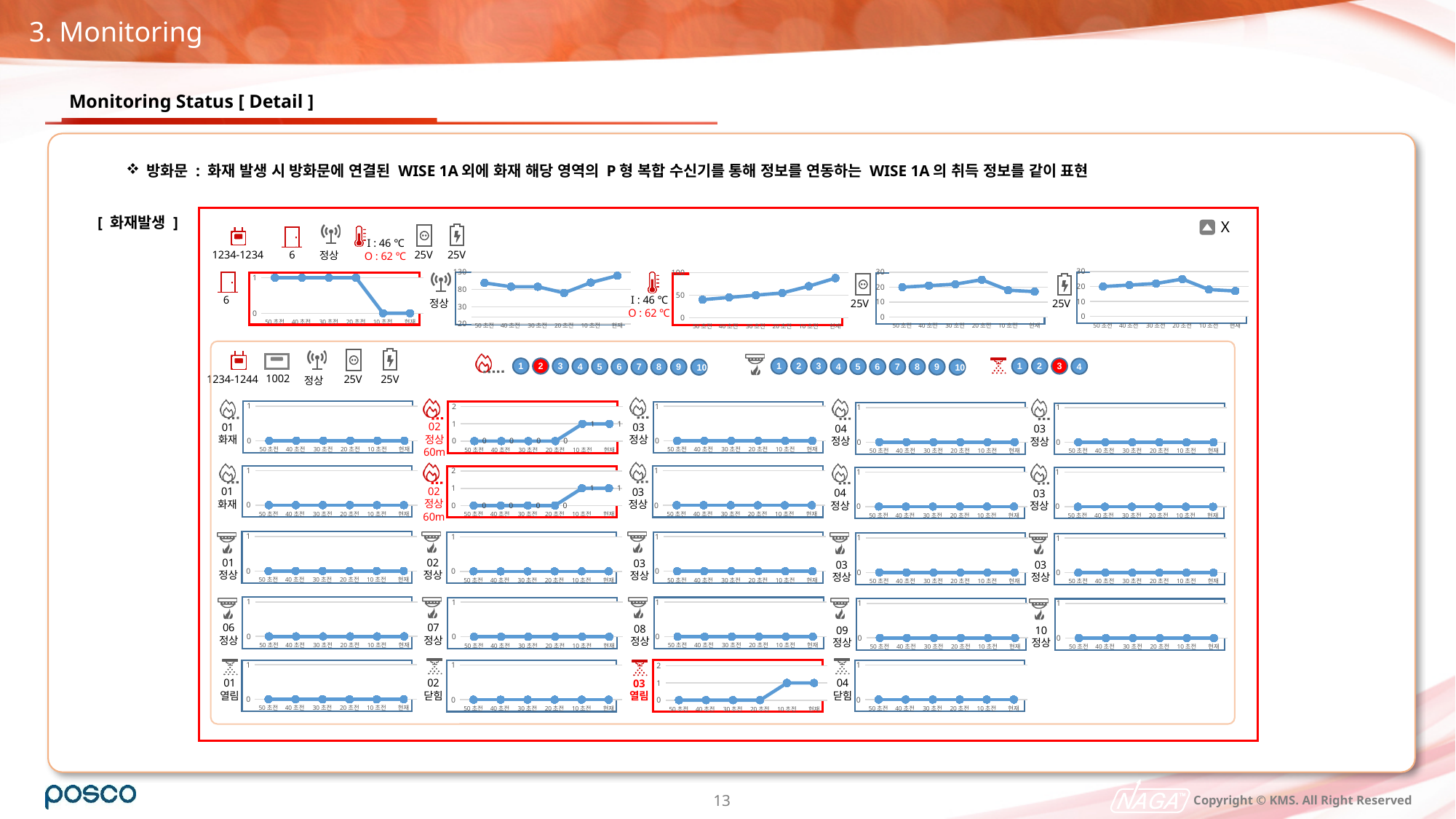
What kind of charts are shown in the monitoring panel on the slide? line charts In the top-row signal chart (정상), is the value at 현재 greater or less than 80? greater What is the label of the last x-axis tick on each small chart? 현재 In the red-bordered chart for 02 정상 60m in the first row of the lower grid, what is the value at 50초전? 0 In the top-row door chart (labelled 6), does the value rise or fall from 50초전 to 현재? fall How many time points are plotted along the x axis of each small chart (from 50초전 to 현재)? 6 In the top-row door chart (labelled 6), what is the value at 50초전? 1 In the red-bordered chart for 03 열림 in the bottom row of the lower grid, does the value rise or fall from 50초전 to 현재? rise In the red-bordered chart for 02 정상 60m in the first row of the lower grid, what is the value at 현재? 1 In the top-row temperature chart (I : 46 °C / O : 62 °C), is the value at 현재 greater or less than 50? greater In the top-row door chart (labelled 6), what is the value at 현재? 0 In the top-row temperature chart (I : 46 °C / O : 62 °C), does the value rise or fall from 50초전 to 현재? rise